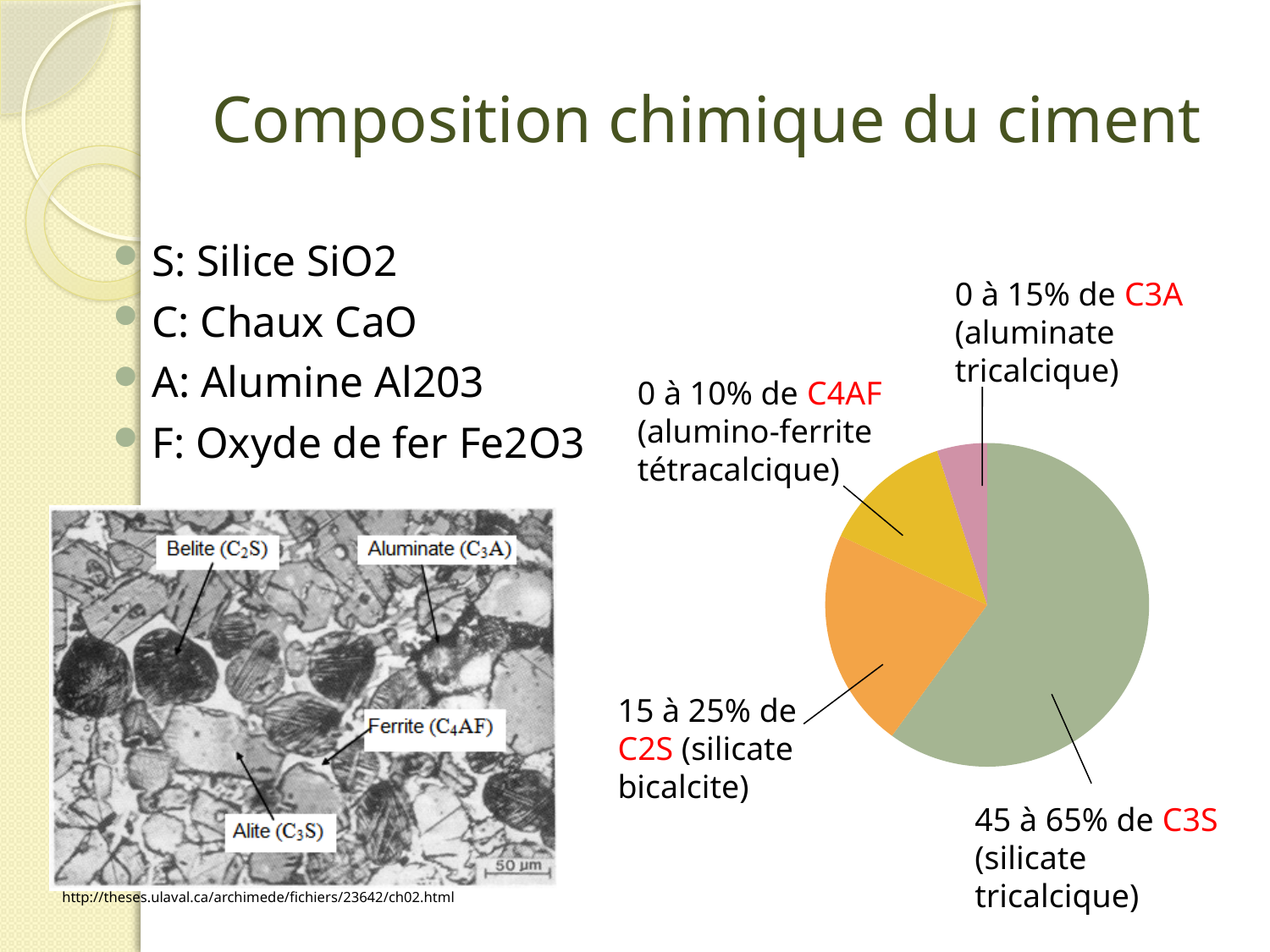
What percentage range is given for C4AF in the pie chart? 0 à 10% What percentage range is given for C3S in the pie chart? 45 à 65% What percentage range is given for C2S in the pie chart? 15 à 25% What colour is the C3S slice in the pie chart? green What percentage range is given for C3A in the pie chart? 0 à 15% What kind of chart is shown on the right of the slide? pie chart How many slices does the pie chart have? 4 Which component has the largest slice in the pie chart? C3S Which slice is larger in the pie chart, C2S or C4AF? C2S Which slice is larger in the pie chart, C3S or C2S? C3S What is the full name given for C2S in the pie chart label? silicate bicalcite Which component has the smallest slice in the pie chart? C3A